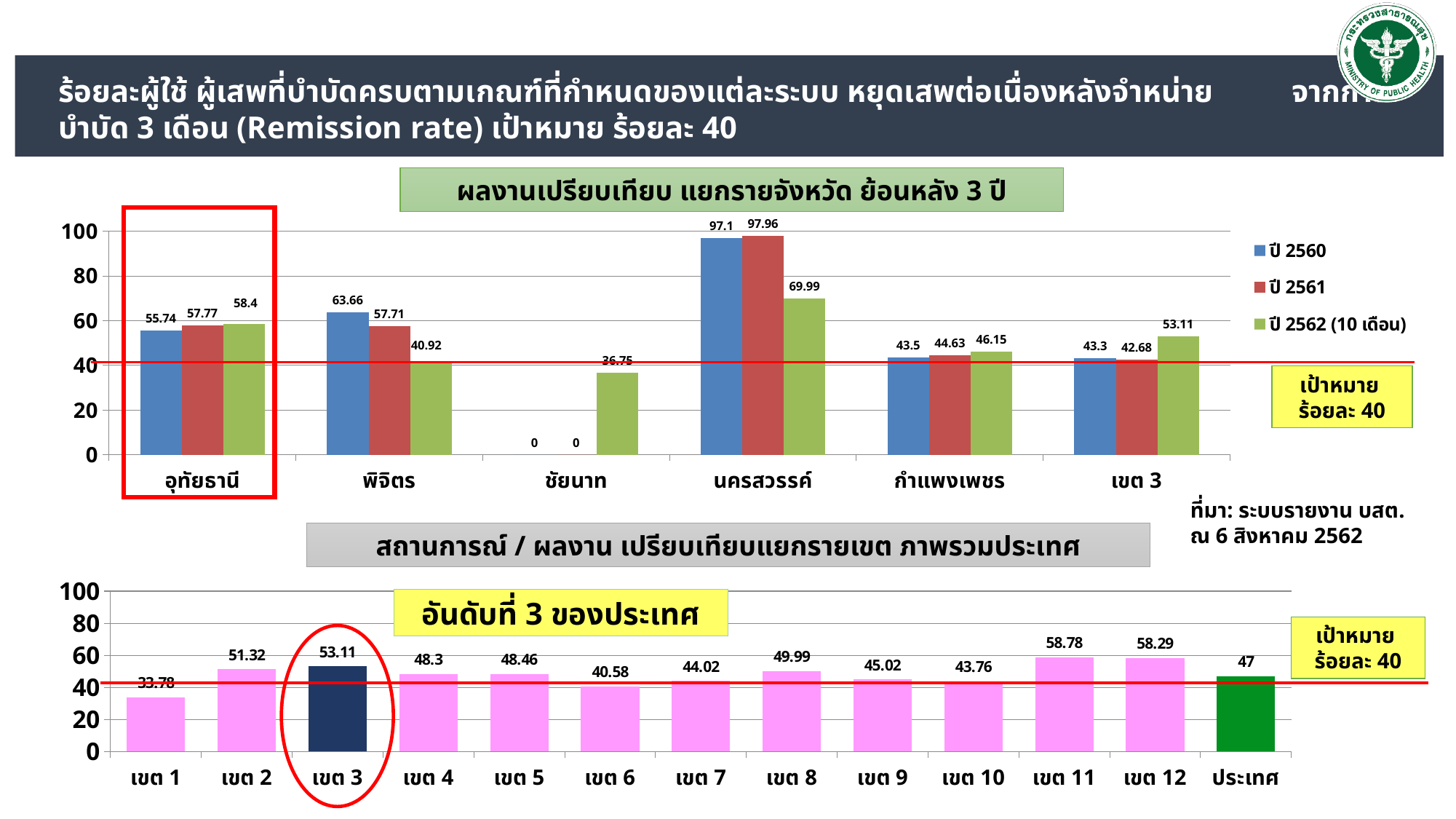
In the bottom chart, which is larger, the value for เขต 3 or the value for เขต 2? เขต 3 What kind of chart is the bottom chart? bar chart In the top chart (ผลงานเปรียบเทียบ แยกรายจังหวัด ย้อนหลัง 3 ปี), what is the value for นครสวรรค์ in ปี 2561? 97.96 In the top chart, what is the difference between the ปี 2562 (10 เดือน) value and the ปี 2560 value for เขต 3? 9.81 In the bottom chart (สถานการณ์ / ผลงาน เปรียบเทียบแยกรายเขต ภาพรวมประเทศ), what is the value for เขต 11? 58.78 In the top chart, what is the value for ชัยนาท in ปี 2560? 0 In the bottom chart, how many categories are shown on the x axis? 13 In the bottom chart, which category has the lowest value? เขต 1 In the top chart, is the value for ชัยนาท in ปี 2562 (10 เดือน) greater or less than 40? less In the top chart, which province has the highest value in ปี 2560? นครสวรรค์ In the top chart, how many series does the legend list? 3 In the top chart, what is the value for พิจิตร in ปี 2562 (10 เดือน)? 40.92